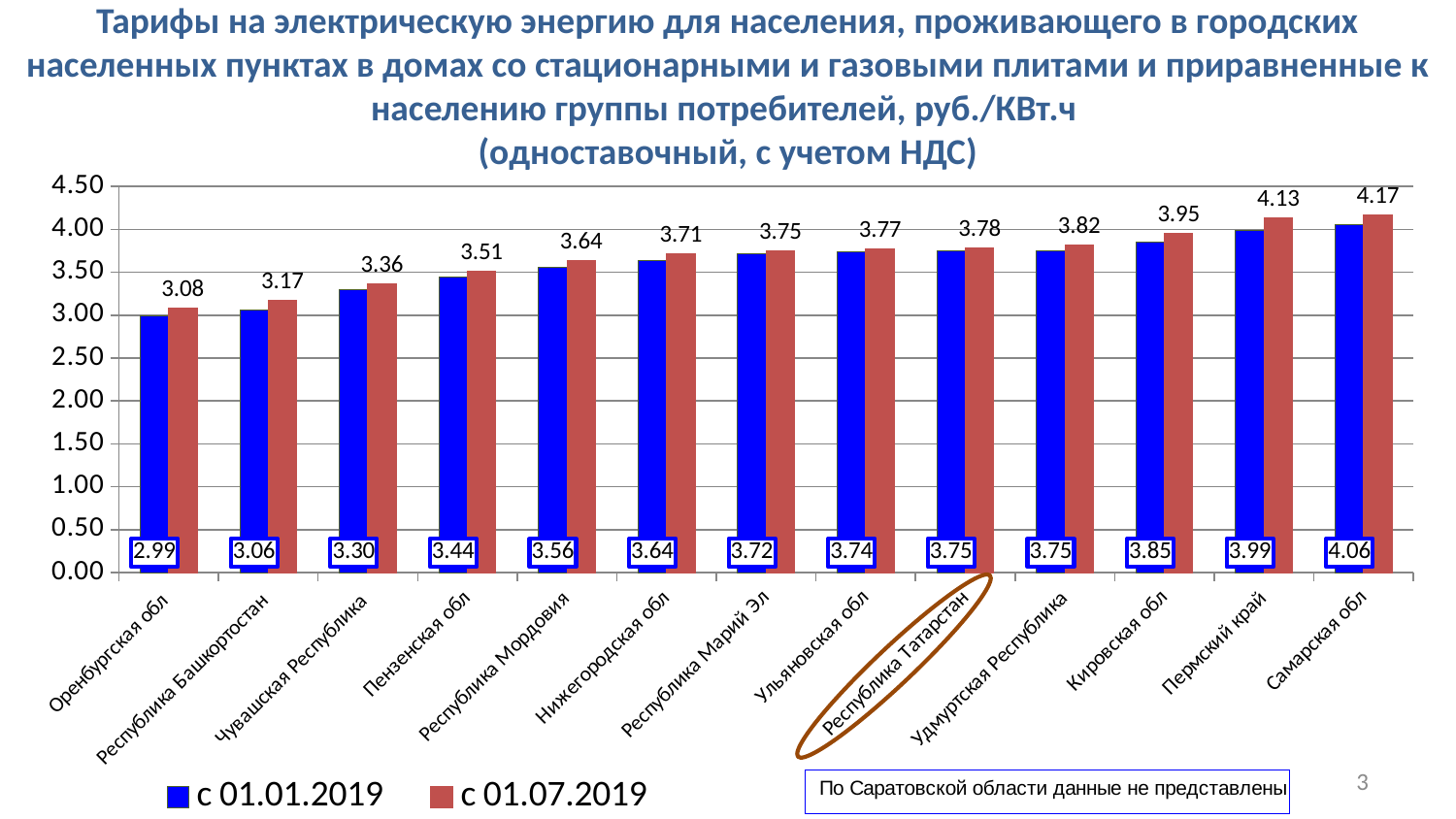
What is the value for Кировская обл in the с 01.07.2019 series? 3.95 Do the с 01.07.2019 values rise or fall from left to right along the x axis? rise Which region has the lowest value in the с 01.01.2019 series? Оренбургская обл What kind of chart is shown on the slide? bar chart How many series does the legend list? 2 What is the value for Республика Татарстан in the с 01.07.2019 series? 3.78 Which is larger: the с 01.01.2019 value for Самарская обл or the с 01.07.2019 value for Пермский край? с 01.07.2019 value for Пермский край Is the с 01.01.2019 value for Республика Башкортостан greater or less than 3.50? less How many regions are shown on the x axis of the chart? 13 Which region has the highest value in the с 01.07.2019 series? Самарская обл What is the difference between the с 01.07.2019 and с 01.01.2019 values for Пермский край? 0.14 What is the value for Пензенская обл in the с 01.01.2019 series? 3.44